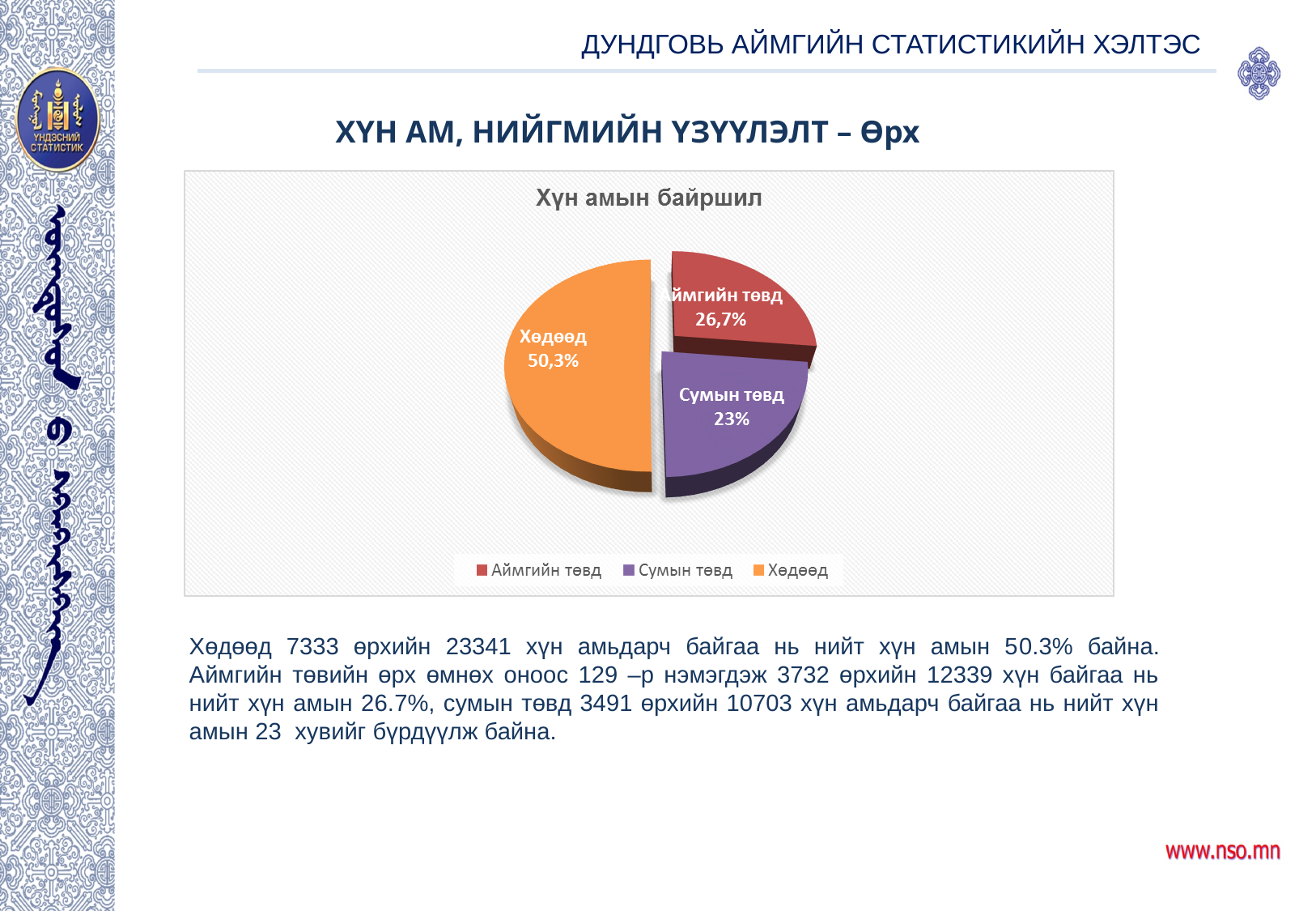
What value is shown for Аймгийн төвд? 26,7% How many slices does the pie chart have? 3 What kind of chart is shown on the slide? Pie chart What share of the pie is labelled for Хөдөөд? 50,3% What is the difference between the share for Хөдөөд and the share for Аймгийн төвд? 23,6 percentage points Which slice of the pie is the largest? Хөдөөд What value is shown for Сумын төвд? 23% What is the title of the chart? Хүн амын байршил How many entries does the chart legend list? 3 Which is larger, the share for Аймгийн төвд or the share for Сумын төвд? Аймгийн төвд What colour is the Хөдөөд slice in the pie chart? Orange Which slice of the pie is the smallest? Сумын төвд